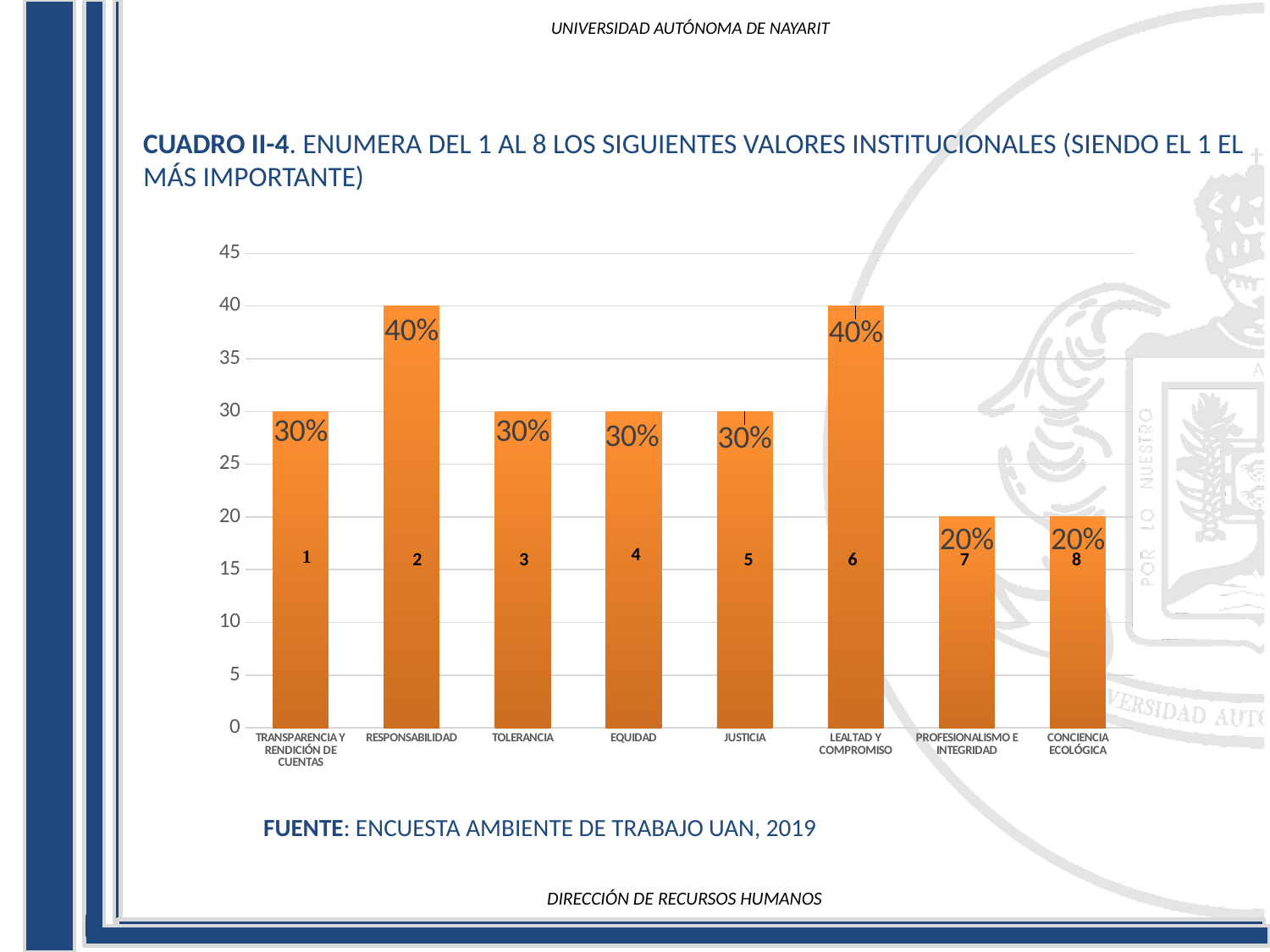
Which value is larger, TOLERANCIA or PROFESIONALISMO E INTEGRIDAD? TOLERANCIA Is the value for EQUIDAD greater or less than 25? greater How many categories are plotted in the chart? 8 What is the data label shown for LEALTAD Y COMPROMISO? 40% What number is printed inside the bar for TRANSPARENCIA Y RENDICIÓN DE CUENTAS? 1 What is the source cited below the chart? ENCUESTA AMBIENTE DE TRABAJO UAN, 2019 What is the data label shown for RESPONSABILIDAD? 40% What type of chart is shown on the slide? bar chart What is the difference between the values for RESPONSABILIDAD and CONCIENCIA ECOLÓGICA? 20% What is the data label shown for CONCIENCIA ECOLÓGICA? 20% What is the data label shown for JUSTICIA? 30% Is the value for PROFESIONALISMO E INTEGRIDAD greater or less than 25? less